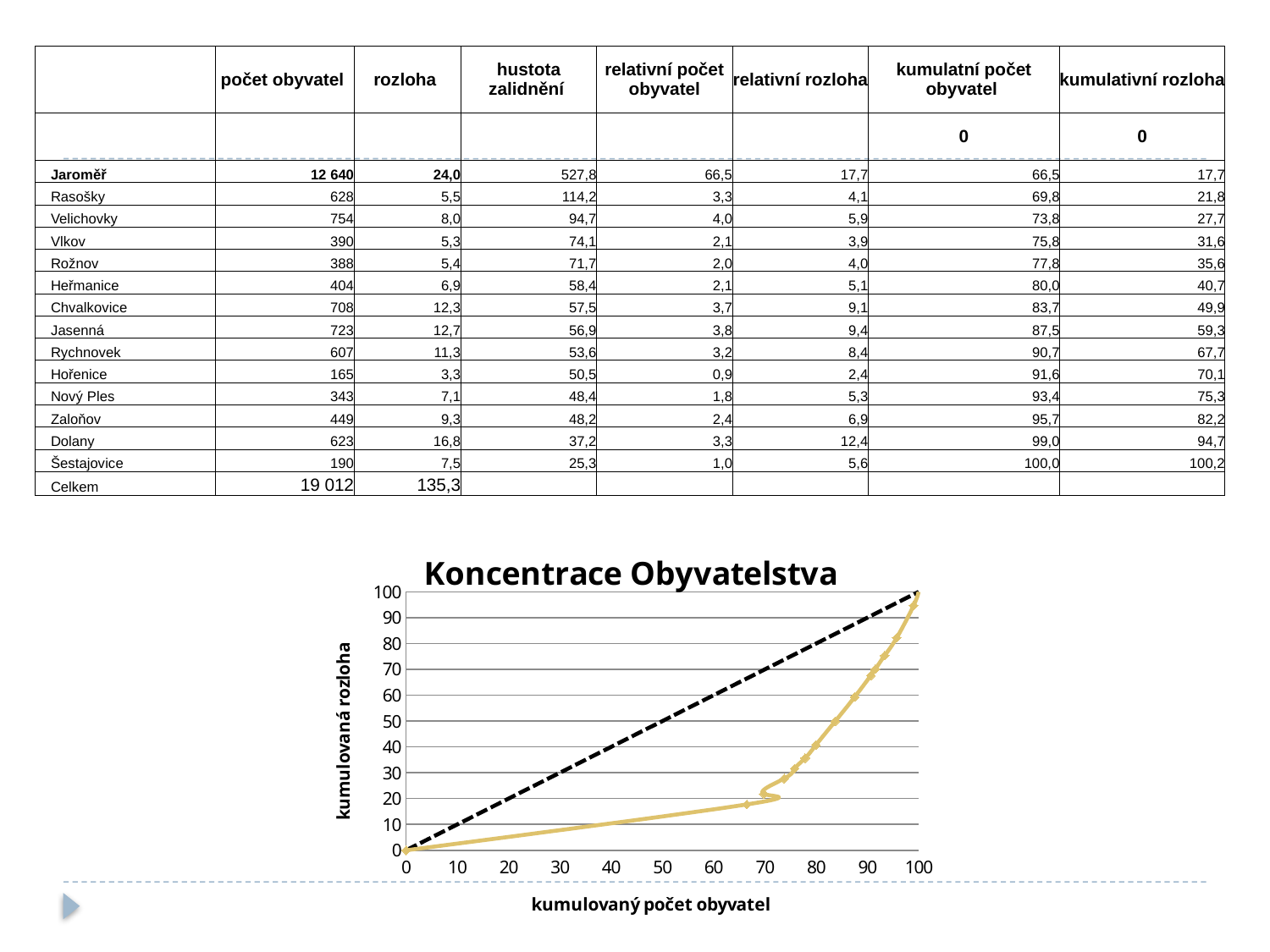
What is the highest value shown on the y axis of the chart? 100 At an x value of 80, is the yellow curve greater or less than 60 on the y axis? less What is the label of the x axis of the chart? kumulovaný počet obyvatel At an x value of 100, is the yellow curve greater or less than 90 on the y axis? greater What is the title of the chart? Koncentrace Obyvatelstva Does the yellow curve rise or fall as the x axis value increases? rise At an x value of 90, is the dashed black line greater or less than 80 on the y axis? greater How many lines are plotted on the chart? 2 What kind of chart is shown on the slide? line chart At an x value of 80, which line has the higher y value, the dashed black line or the yellow curve? the dashed black line